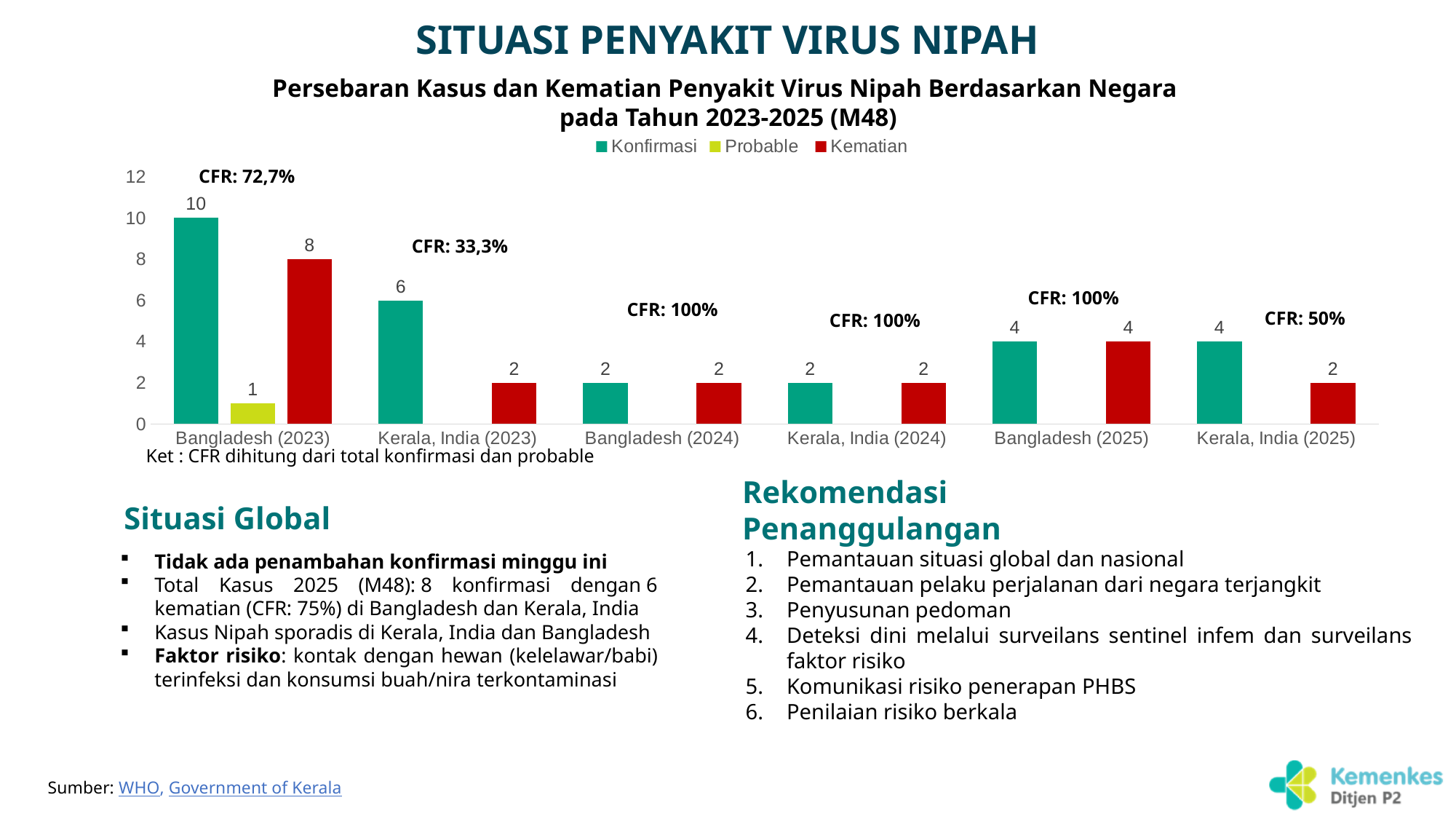
What CFR is shown above Bangladesh (2023)? CFR: 72,7% What is the Kematian value for Kerala, India (2023)? 2 How many categories are shown on the x axis? 6 What is the Probable value for Bangladesh (2023)? 1 What kind of chart is shown? bar chart What is the Konfirmasi value for Bangladesh (2023)? 10 What is the difference between the Konfirmasi and Kematian values for Bangladesh (2023)? 2 Which category has the highest Konfirmasi value? Bangladesh (2023) How many series does the legend list? 3 Which colour represents the Kematian series? red Which category has the highest Kematian value? Bangladesh (2023) Which is larger, the Konfirmasi value for Kerala, India (2023) or the Konfirmasi value for Bangladesh (2025)? Kerala, India (2023)